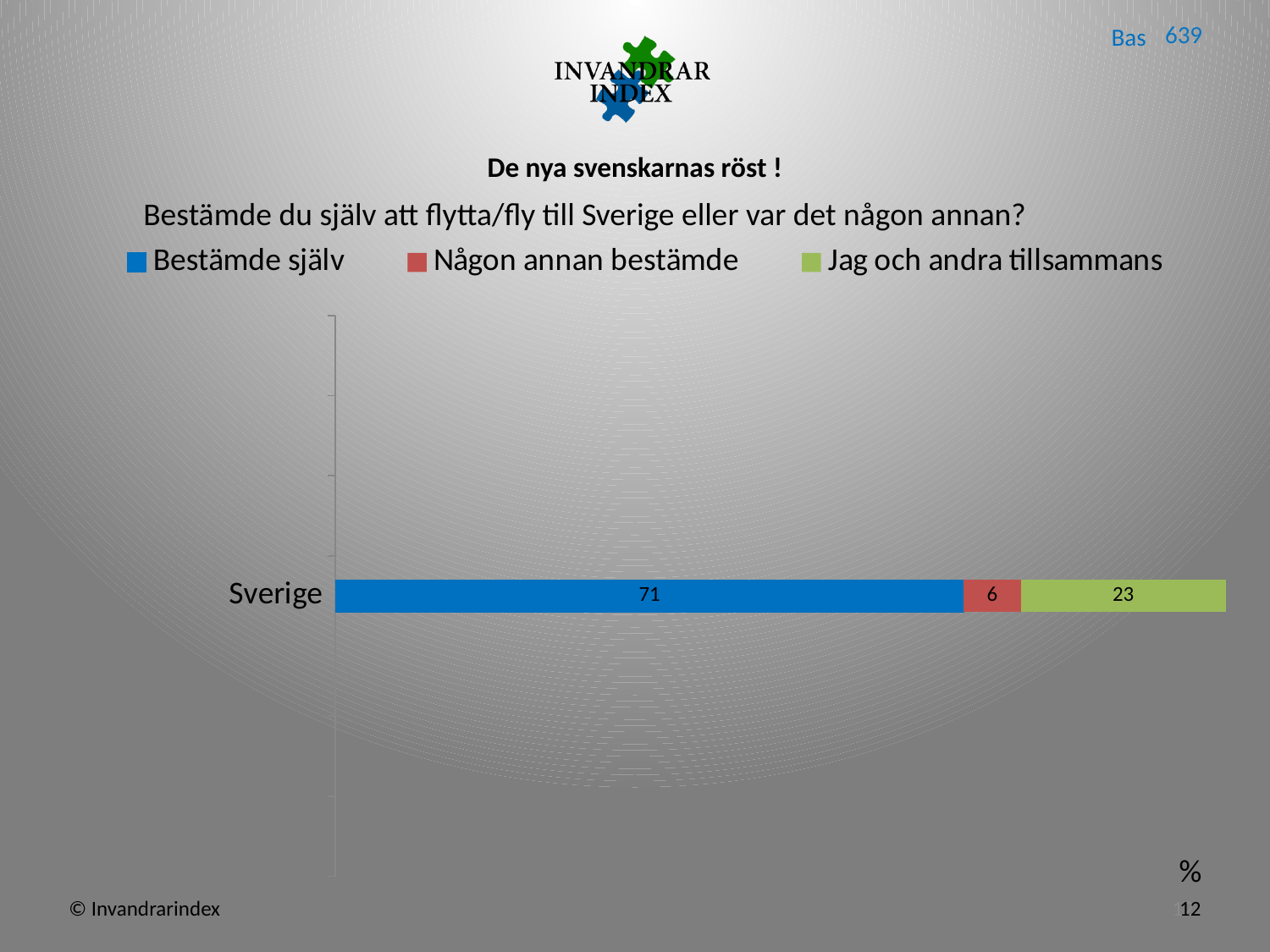
How many series does the legend list? 3 What is the difference between "Bestämde själv" and "Jag och andra tillsammans" for Sverige? 48 What is the total of the stacked bar for Sverige? 100 What colour represents "Någon annan bestämde" in the chart? Red Which series has the lowest value for Sverige? Någon annan bestämde How many categories are shown on the chart? 1 What is the value for "Bestämde själv" for Sverige? 71 What is the value for "Jag och andra tillsammans" for Sverige? 23 What is the value for "Någon annan bestämde" for Sverige? 6 What kind of chart is shown on the slide? Bar chart Which series has the highest value for Sverige? Bestämde själv Which is larger for Sverige: "Jag och andra tillsammans" or "Någon annan bestämde"? Jag och andra tillsammans